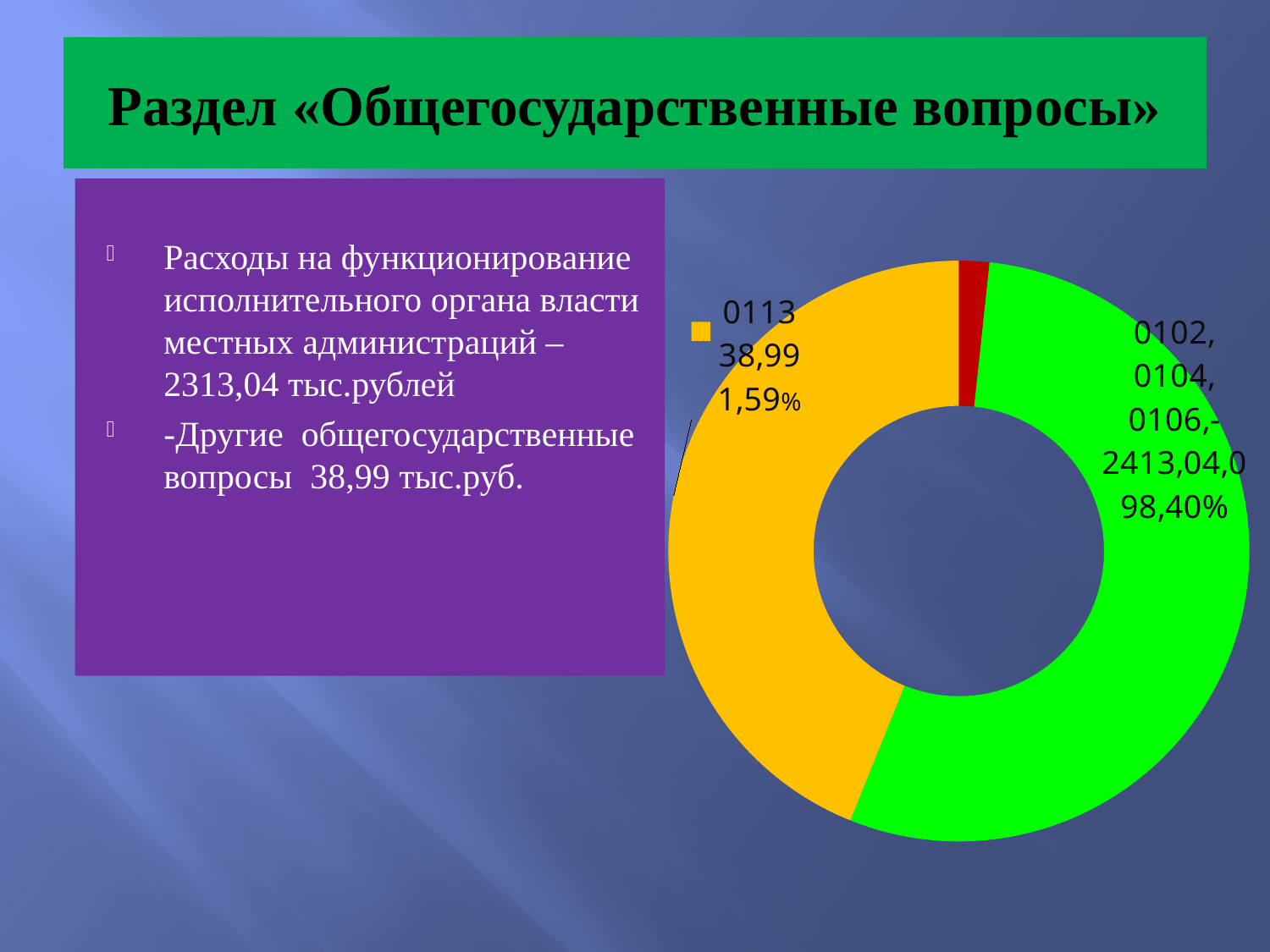
What value is printed for the slice labelled 0113? 38,99 What value is printed for the slice labelled 0102, 0104, 0106? 2413,04,0 Which labelled slice has the lowest printed percentage? 0113 What percentage is printed for the slice labelled 0113? 1,59% Which labelled slice has the highest printed percentage? 0102, 0104, 0106 What colour is the slice labelled 0102, 0104, 0106? Green What colour is the slice labelled 0113? Orange How many slices does the chart contain? 3 What percentage is printed for the slice labelled 0102, 0104, 0106? 98,40% Which slice is larger by printed percentage, 0113 or 0102, 0104, 0106? 0102, 0104, 0106 What kind of chart is shown on the slide? Pie (doughnut) chart